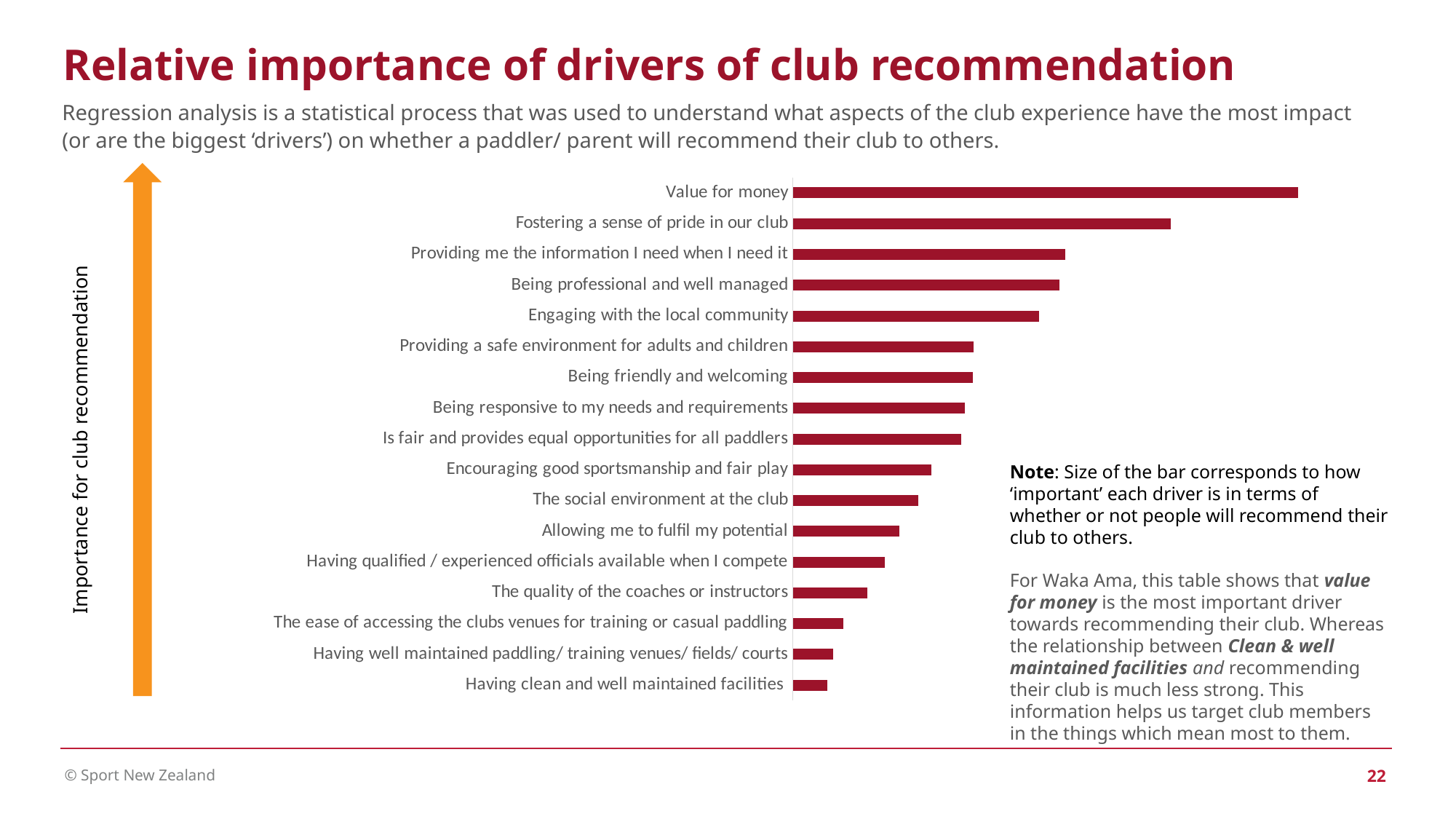
Which driver is listed second from the top of the chart? Fostering a sense of pride in our club Which has the longer bar: 'Having qualified / experienced officials available when I compete' or 'The ease of accessing the clubs venues for training or casual paddling'? Having qualified / experienced officials available when I compete Which driver has the shortest bar in the chart? Having clean and well maintained facilities What is the label on the vertical arrow to the left of the chart? Importance for club recommendation Which has the longer bar: 'Value for money' or 'Fostering a sense of pride in our club'? Value for money Which has the longer bar: 'Being professional and well managed' or 'The social environment at the club'? Being professional and well managed Which driver has the longest bar in the chart? Value for money Do the bar lengths increase or decrease going from the top of the chart to the bottom? Decrease What kind of chart is shown on the slide? Bar chart How many drivers (bars) are shown in the chart? 17